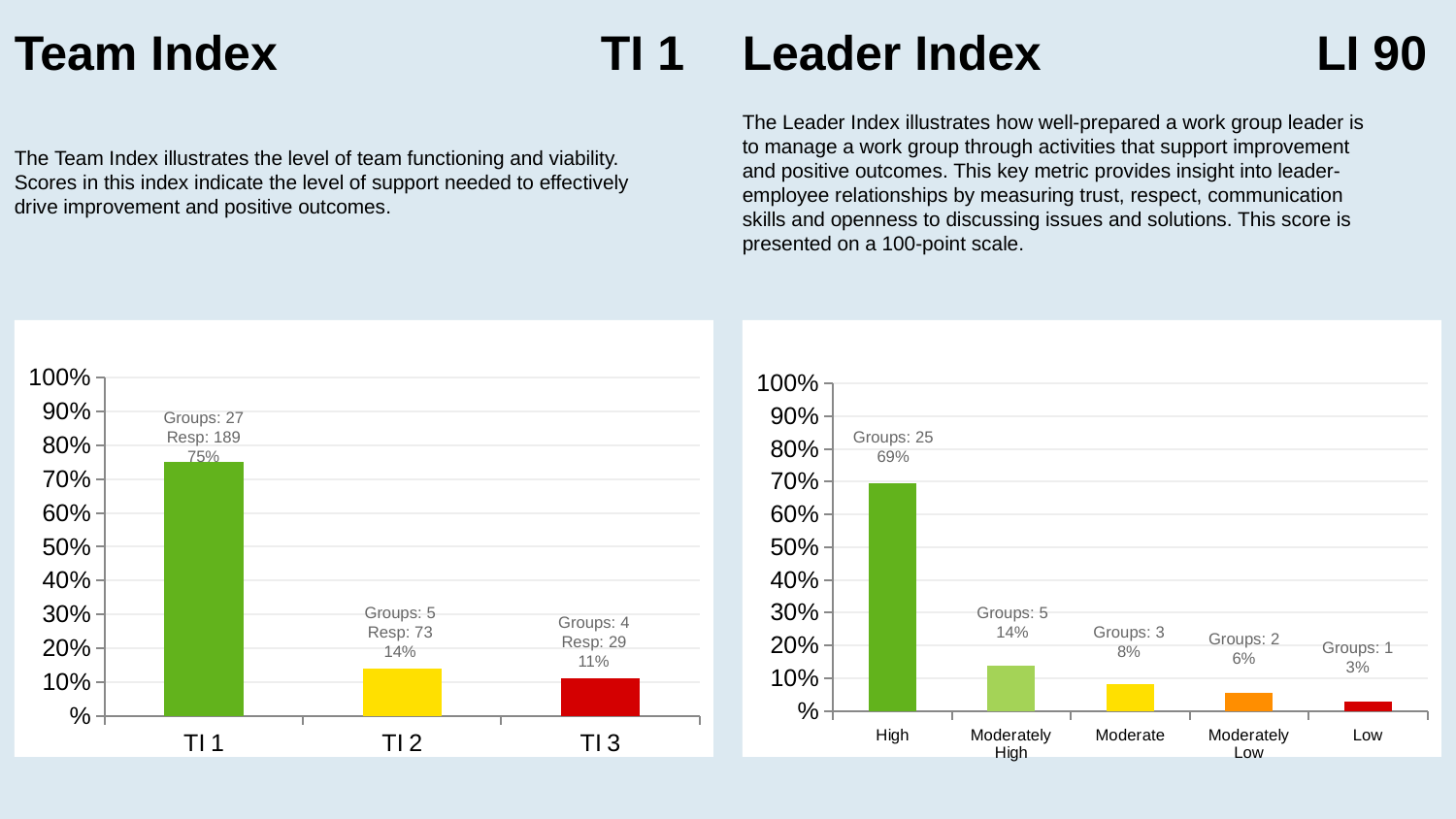
In the Team Index chart on the left, what is the difference in percentage points between TI 1 and TI 2? 61 In the Leader Index chart on the right, do the values rise or fall from High to Low along the x axis? fall In the Team Index chart on the left, how many categories are shown on the x axis? 3 In the Leader Index chart on the right, what percentage is shown for Moderate? 8% In the Leader Index chart on the right, which category has the highest percentage? High In the Leader Index chart on the right, is the value for Moderately High greater or less than Low? greater In the Team Index chart on the left, what percentage is shown for TI 1? 75% In the Team Index chart on the left, which category has the lowest percentage? TI 3 In the Team Index chart on the left, what is the Resp value for TI 3? 29 In the Leader Index chart on the right, how many groups are reported for Moderately Low? 2 In the Team Index chart on the left, how many groups are reported for TI 2? 5 What kind of chart is the Leader Index chart on the right? bar chart